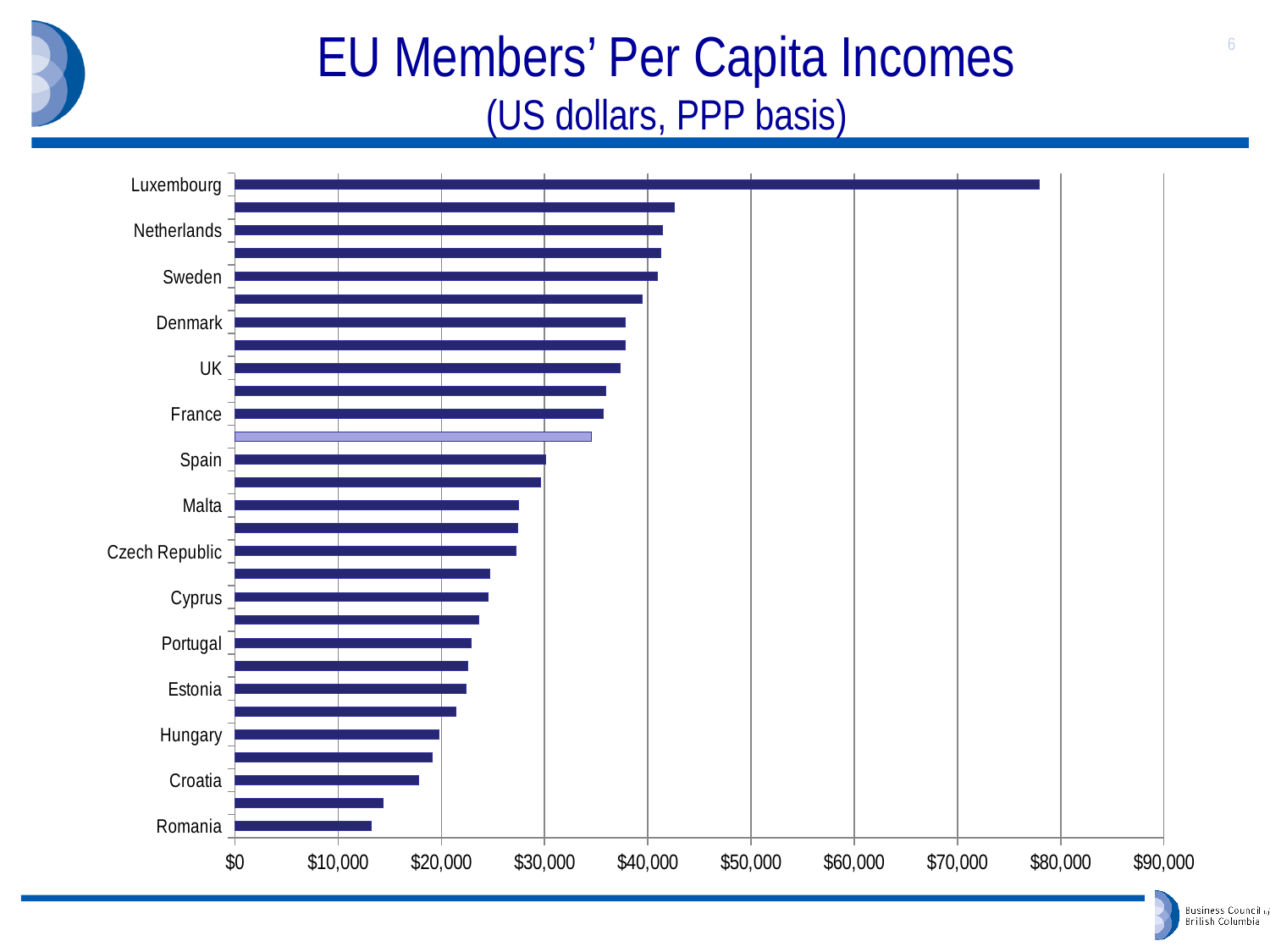
Which has the larger per capita income, Denmark or Spain? Denmark What kind of chart is shown on the slide? bar chart Do the bar values rise or fall moving from the top of the chart to the bottom? fall Which country has the highest per capita income in the chart? Luxembourg Is the value for Malta greater or less than $30,000? less Is the value for Croatia greater or less than $20,000? less Is the value for Luxembourg greater or less than $70,000? greater Which labelled country has the lowest per capita income in the chart? Romania What is the title of the chart on the slide? EU Members' Per Capita Incomes (US dollars, PPP basis)